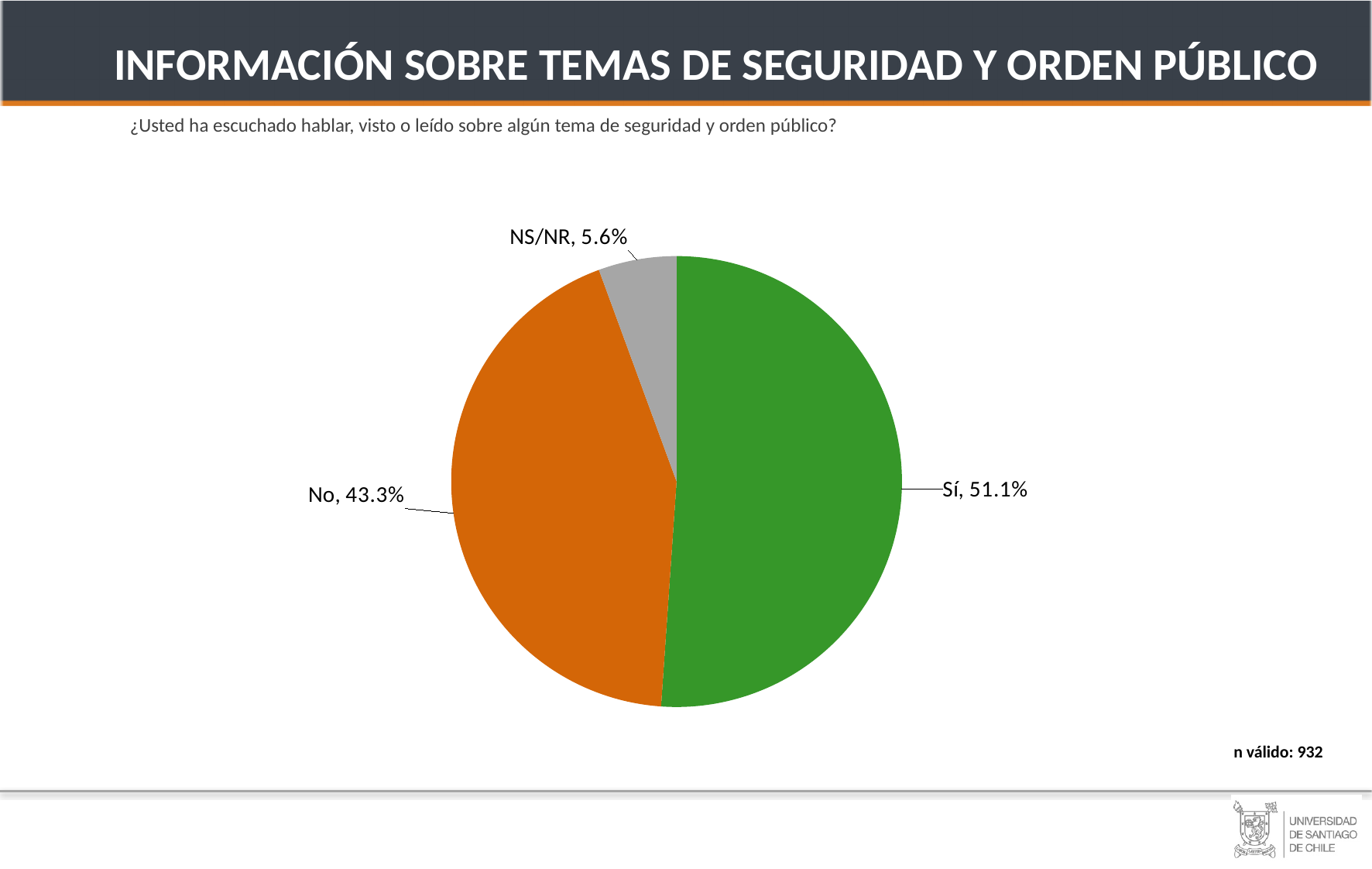
What percentage of respondents answered "No"? 43.3% What colour is the "Sí" slice? green What is the valid n reported on the slide? 932 What is the difference in percentage points between the "No" and NS/NR slices? 37.7 How many slices does the pie chart have? 3 Which category has the smallest share of the pie? NS/NR What kind of chart is shown on the slide? pie chart What percentage of respondents answered "Sí"? 51.1% What is the value of the NS/NR slice? 5.6% What is the difference in percentage points between the "Sí" and "No" slices? 7.8 Which is larger, the "No" slice or the NS/NR slice? No Which category has the largest share of the pie? Sí